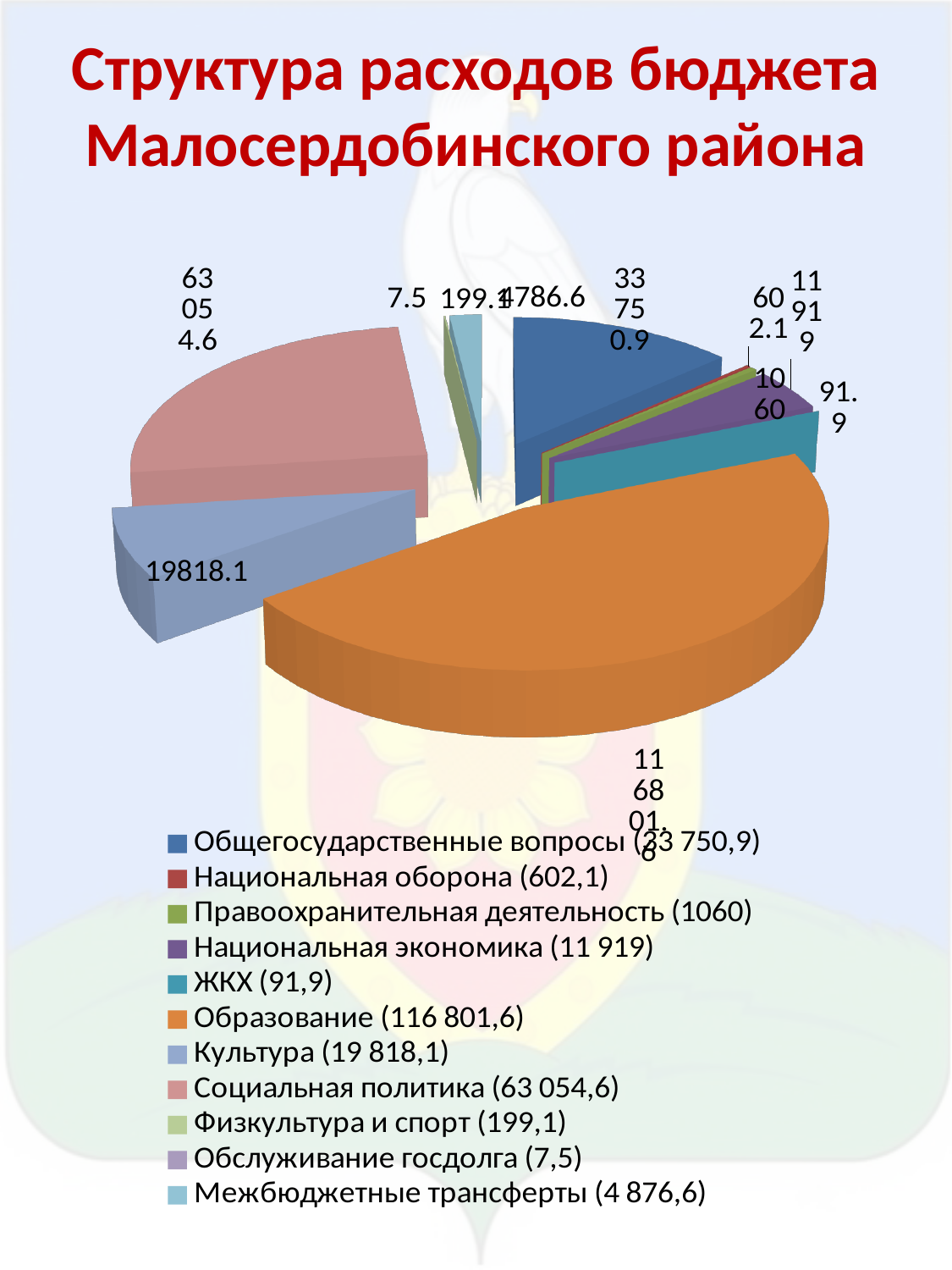
What is the title of the slide? Структура расходов бюджета Малосердобинского района Which category has the smallest value in the pie chart? Обслуживание госдолга Which category has the largest value in the pie chart? Образование Which is larger, Культура or Национальная экономика? Культура What is the difference between Общегосударственные вопросы (33 750,9) and Культура (19 818,1)? 13 932,8 What kind of chart is shown on the slide? pie chart What colour is the slice for Образование? orange What is the value shown for Социальная политика in the legend? 63 054,6 How many categories does the pie chart's legend list? 11 What is the value shown for ЖКХ in the legend? 91,9 What is the value shown for Образование in the legend? 116 801,6 What is the value shown for Межбюджетные трансферты in the legend? 4 876,6